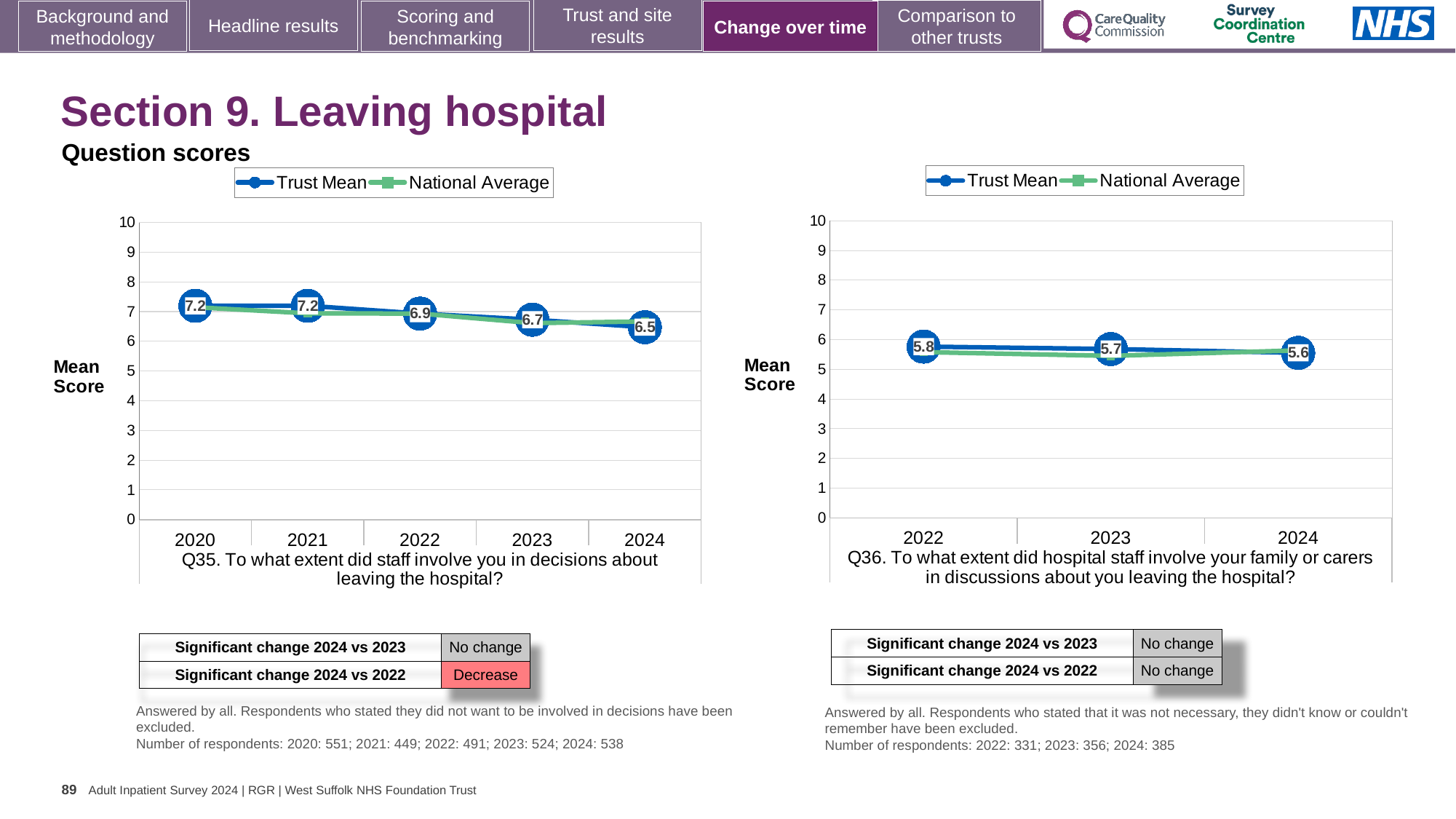
On the Q36 chart (right), what is the Trust Mean score for 2024? 5.6 What type of chart is used for Q35 (left)? line chart How many series does the legend of the Q35 chart (left) list? 2 On the Q35 chart (left), in which year is the Trust Mean lowest? 2024 On the Q35 chart (left), what is the difference between the Trust Mean in 2020 and in 2024? 0.7 How many years are plotted on the Q36 chart (right)? 3 On the Q36 chart (right), in which year is the Trust Mean highest? 2022 On the Q35 chart (left), does the Trust Mean rise or fall from 2020 to 2024? fall On the Q36 chart (right), what is the Trust Mean score for 2022? 5.8 On the Q35 chart (left), what is the Trust Mean score for 2020? 7.2 On the Q35 chart (left), what is the Trust Mean score for 2024? 6.5 On the Q36 chart (right), what is the difference between the Trust Mean in 2022 and in 2024? 0.2